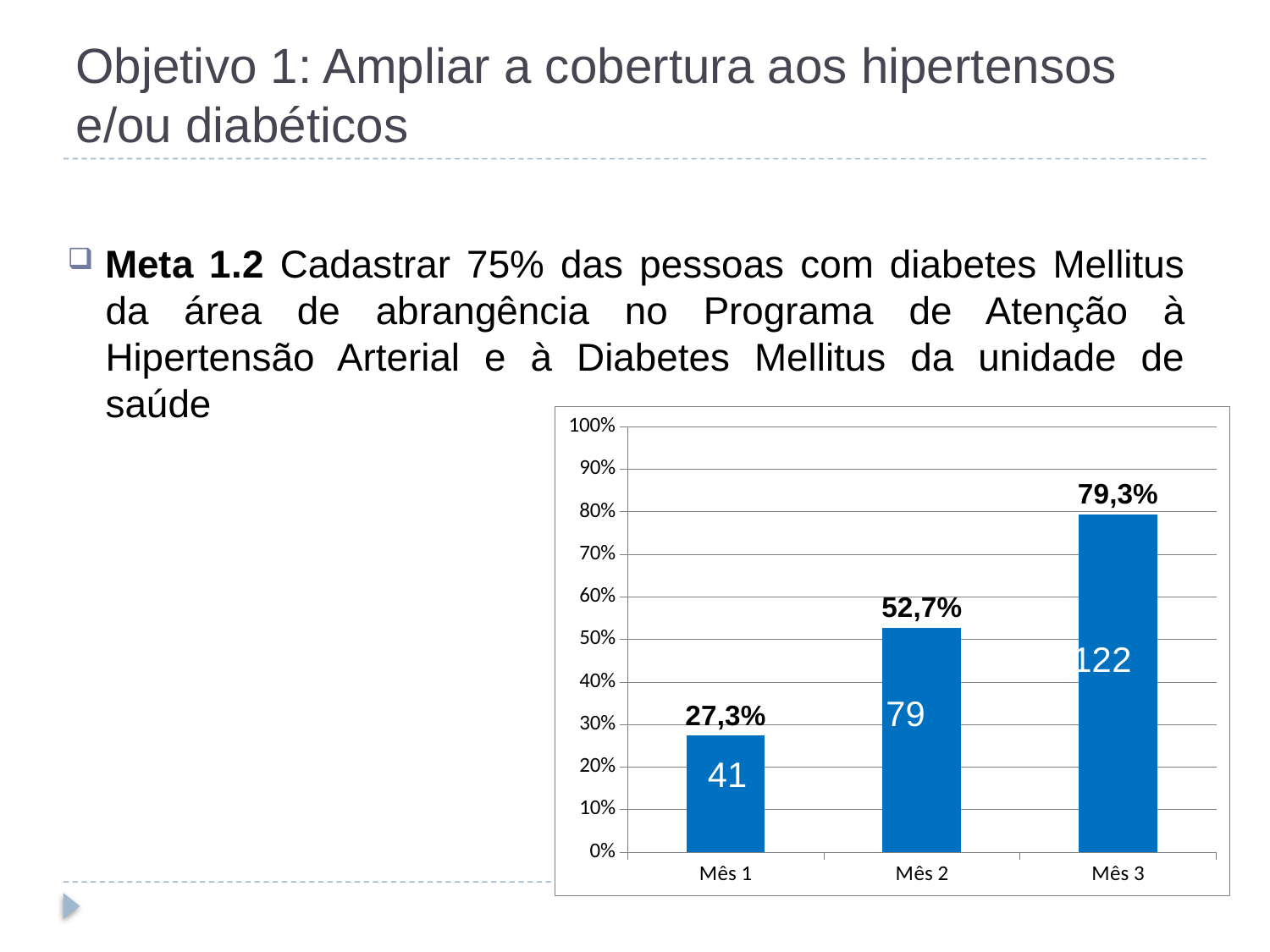
Is the value for Mês 2 greater or less than 50%? greater What is the percentage value shown for Mês 3? 79,3% Do the values rise or fall from Mês 1 to Mês 3? rise Which month has the lowest percentage? Mês 1 What is the difference in percentage points between Mês 3 and Mês 1? 52 percentage points What number is printed inside the bar for Mês 3? 122 What number is printed inside the bar for Mês 1? 41 What is the percentage value shown for Mês 2? 52,7% What is the percentage value shown for Mês 1? 27,3% How many months are shown on the x axis? 3 Which month has the highest percentage? Mês 3 Which is larger, the percentage for Mês 2 or for Mês 1? Mês 2